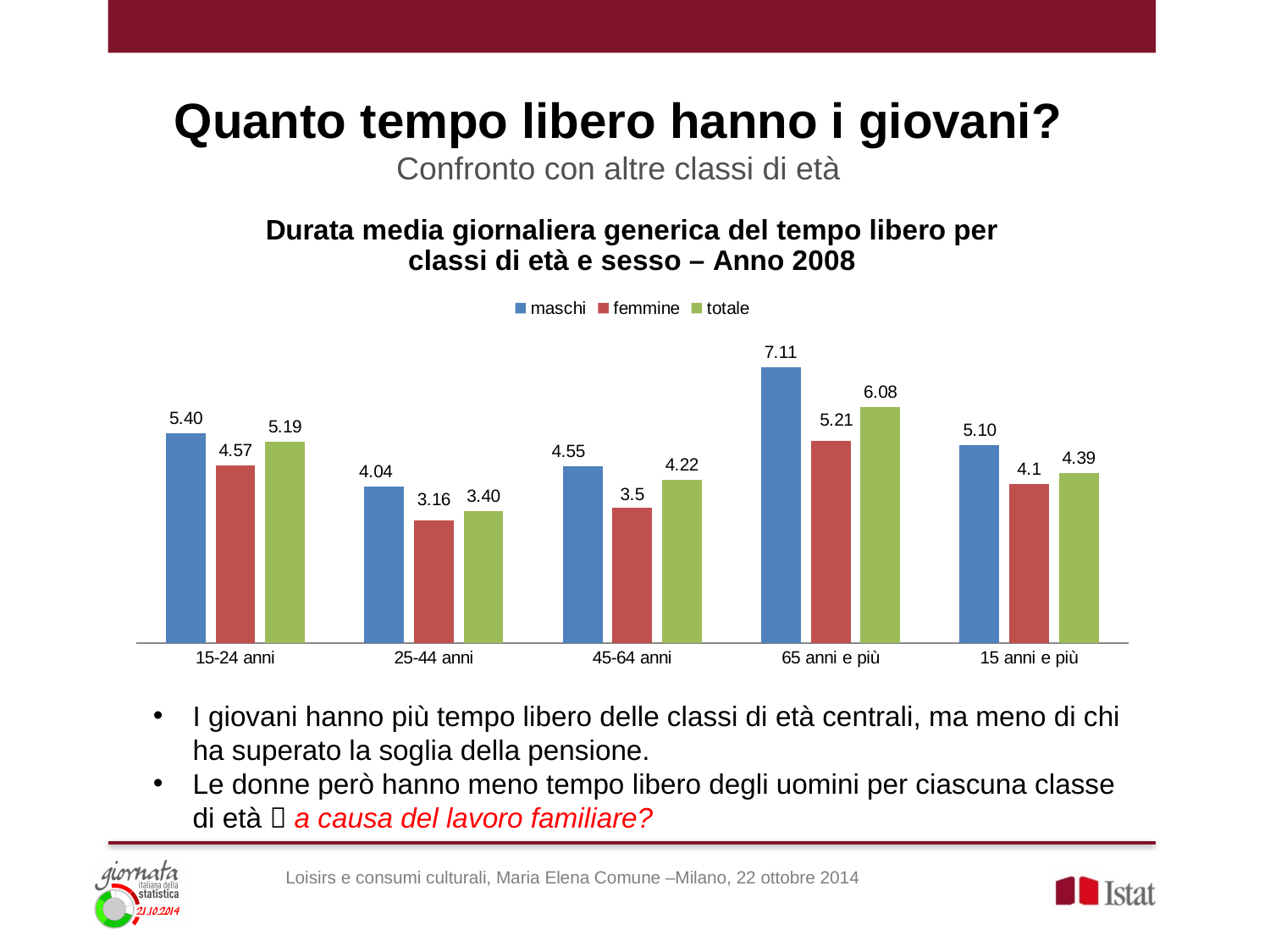
What is the value for maschi in the 15-24 anni category? 5.40 Which colour represents the femmine series in the chart? red How many series does the legend list? 3 What is the value for totale in the 65 anni e più category? 6.08 How many age categories are shown on the x axis? 5 What is the value for femmine in the 15 anni e più category? 4.1 Which age category has the highest value for maschi? 65 anni e più Which age category has the lowest value for femmine? 25-44 anni Which is larger, the totale value for 15-24 anni or the totale value for 45-64 anni? 15-24 anni What is the value for totale in the 45-64 anni category? 4.22 What is the value for femmine in the 25-44 anni category? 3.16 What kind of chart is shown on the slide? bar chart